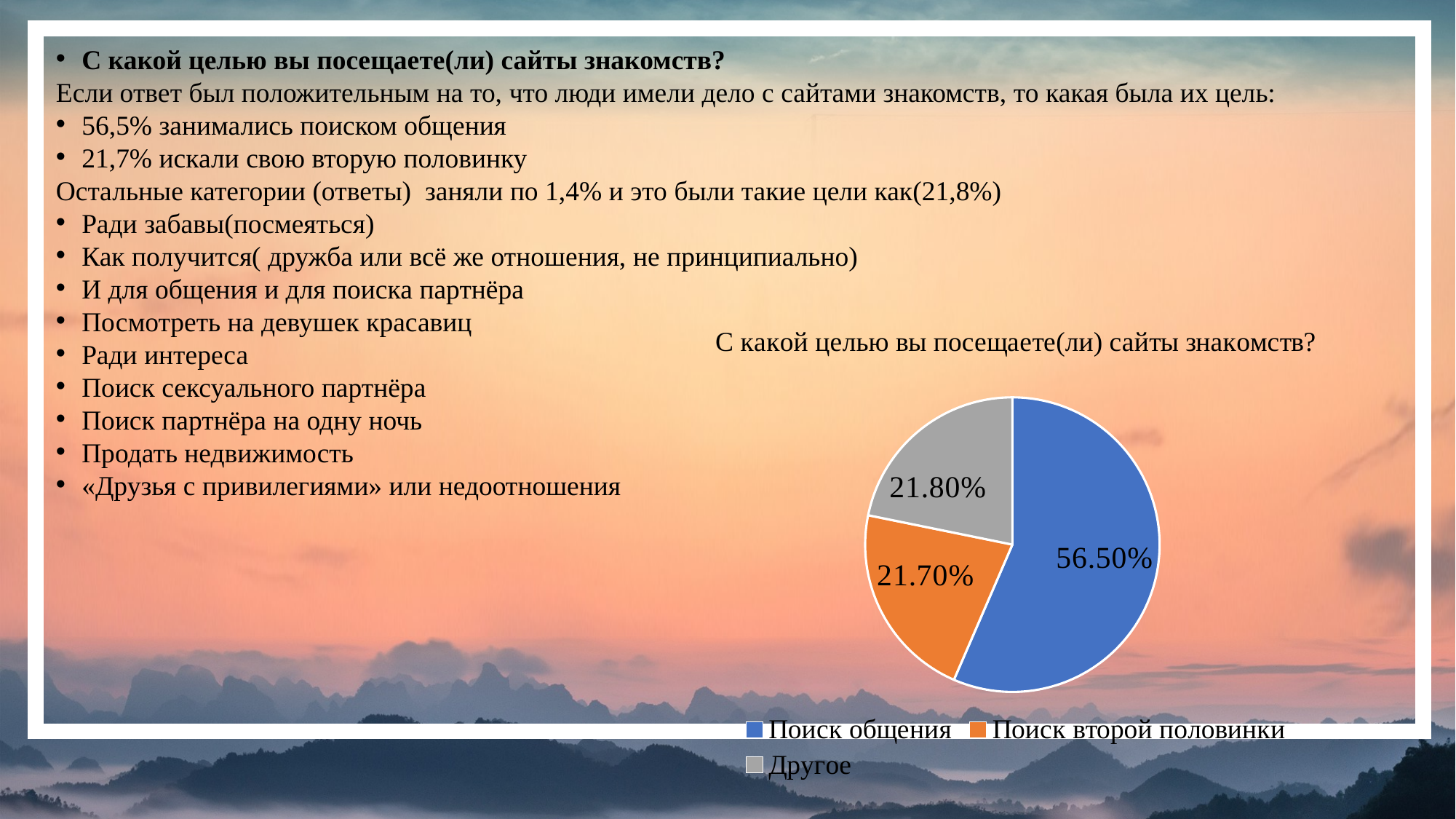
What kind of chart is shown on the slide? pie chart What share of the pie does "Поиск второй половинки" have? 21.70% What is the difference between the shares of "Поиск общения" and "Поиск второй половинки"? 34.80% What share of the pie does "Поиск общения" have? 56.50% What is the title of the pie chart? С какой целью вы посещаете(ли) сайты знакомств? Which is larger: the slice for "Поиск общения" or the slice for "Другое"? Поиск общения Is the share for "Поиск общения" greater or less than 50%? greater How many slices does the pie chart have? 3 How many entries does the legend list? 3 Which category has the largest slice of the pie? Поиск общения What colour is the slice for "Поиск второй половинки"? orange What share of the pie does "Другое" have? 21.80%